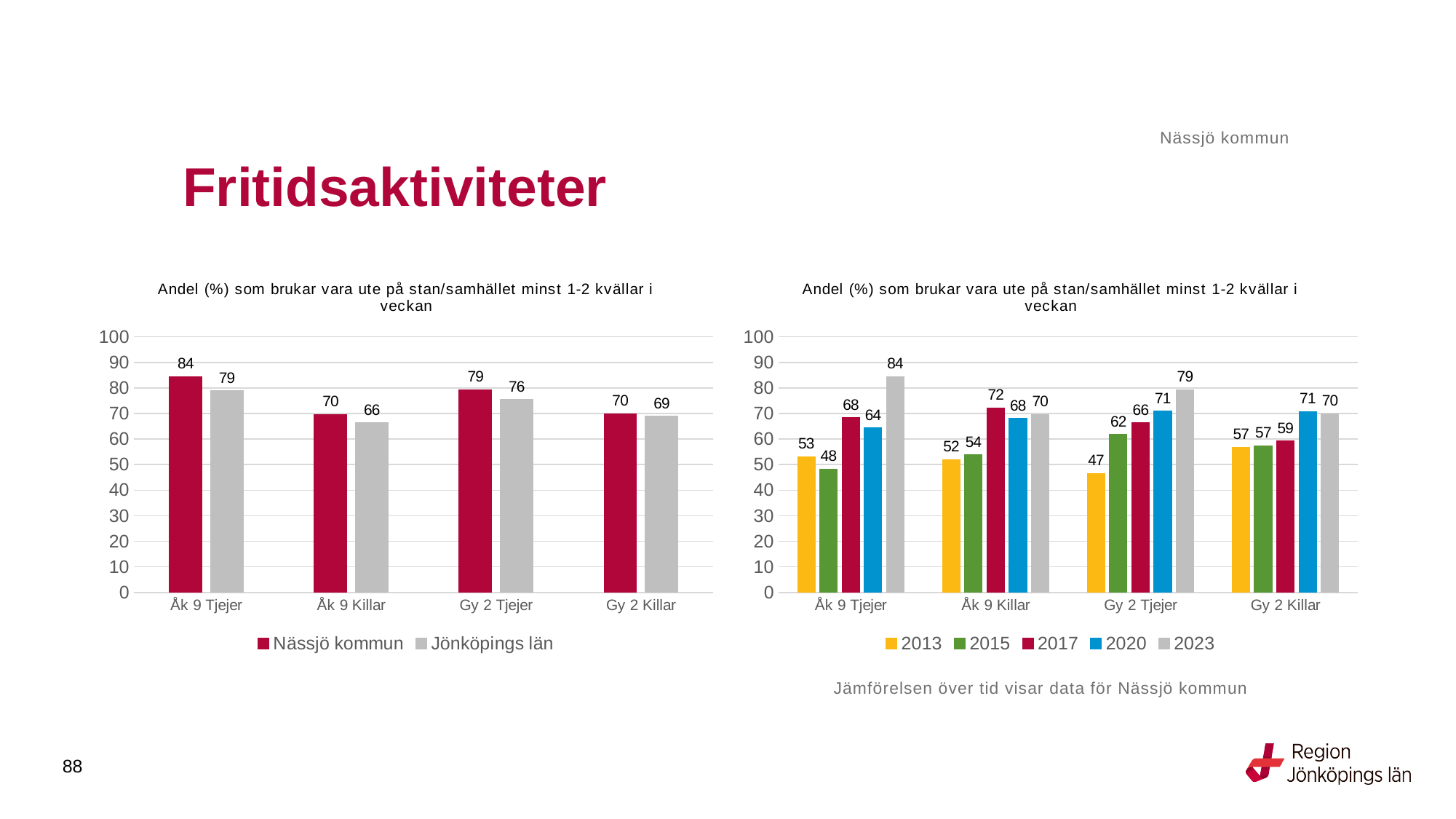
In the left chart, how many series does the legend list? 2 In the right chart, what is the value for 2013 for Gy 2 Tjejer? 47 In the left chart, which category has the lowest value for Jönköpings län? Åk 9 Killar In the left chart, what is the value for Jönköpings län for Gy 2 Tjejer? 76 In the right chart, which year has the highest value for Åk 9 Killar? 2017 In the right chart, how many series does the legend list? 5 In the left chart, what is the difference between Nässjö kommun and Jönköpings län for Åk 9 Killar? 4 In the left chart, what is the value for Nässjö kommun for Åk 9 Tjejer? 84 What type of chart is the left chart? Bar chart In the right chart, what is the value for 2023 for Åk 9 Tjejer? 84 In the right chart, is the value for 2020 for Gy 2 Killar larger or smaller than the value for 2023 for Gy 2 Killar? larger In the right chart, what is the difference between the 2023 and 2013 values for Gy 2 Tjejer? 32